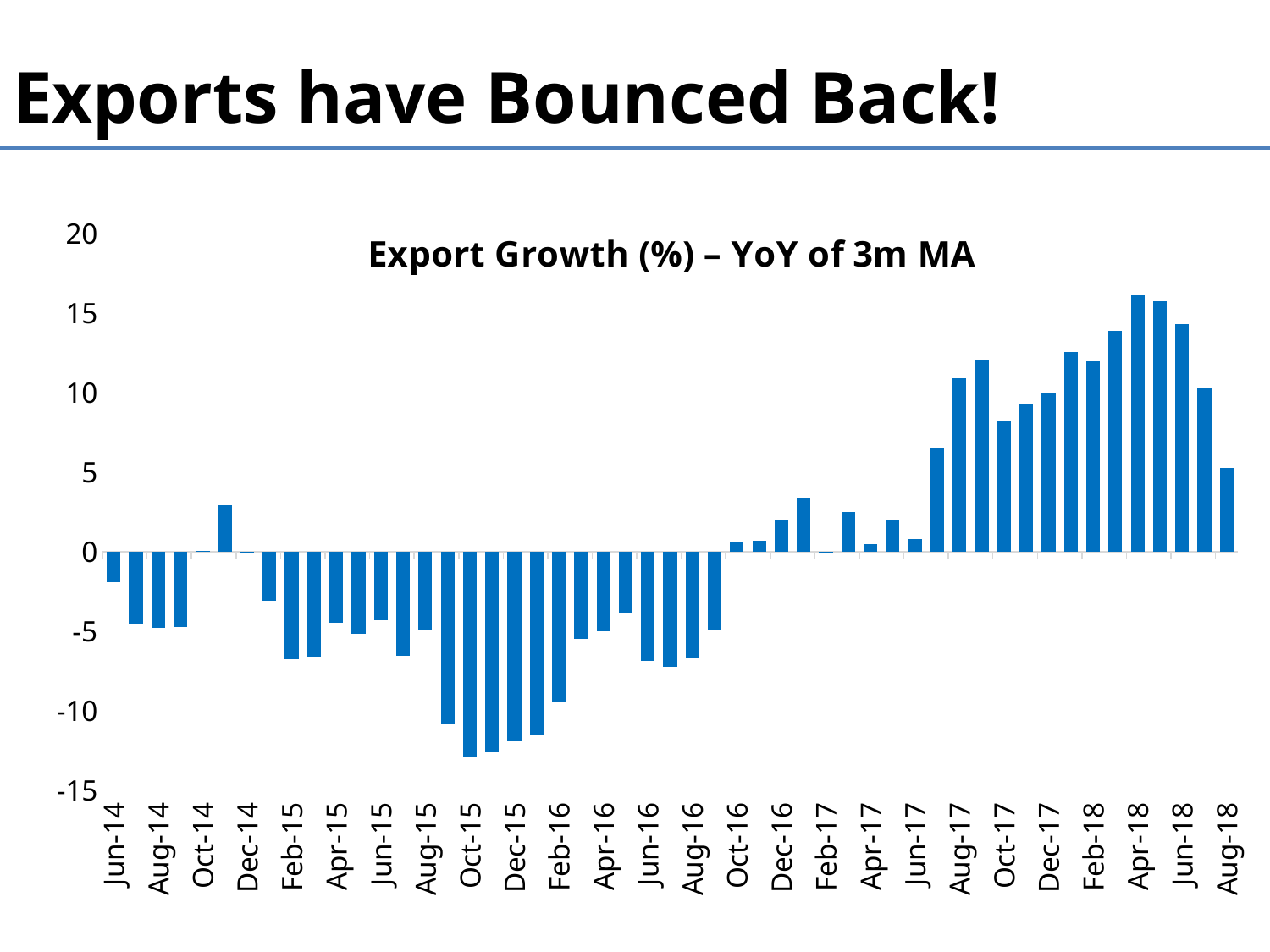
What is the title of the chart? Export Growth (%) – YoY of 3m MA Is the value for Jun-18 greater or less than 15? less Is the value for Oct-15 greater or less than -10? less Is the value for Oct-17 greater or less than 10? less Which month has the highest export growth value? Apr-18 Which is larger, the value for Apr-18 or the value for Aug-18? Apr-18 What kind of chart is shown on the slide? bar chart Do the values generally rise or fall from Apr-18 to Aug-18? fall